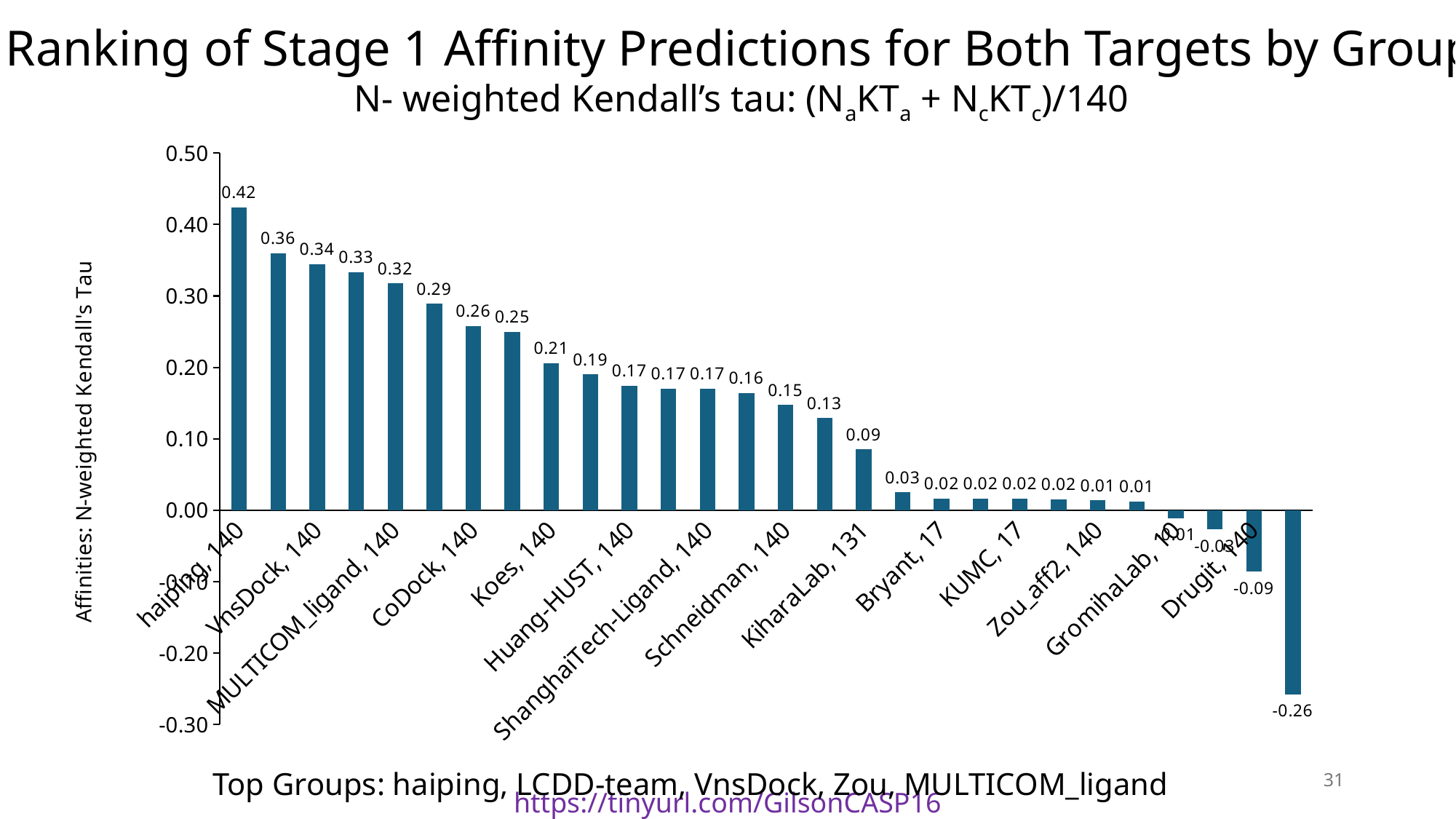
Which group has the highest N-weighted Kendall's tau? haiping, 140 What is the difference between the values for haiping, 140 and VnsDock, 140? 0.08 What type of chart is shown on the slide? bar chart How many bars are plotted in the chart? 28 What is the value shown for KiharaLab, 131? 0.09 Which has a larger value, Koes, 140 or CoDock, 140? CoDock, 140 What is the value shown for CoDock, 140? 0.26 What is the lowest value plotted in the chart? -0.26 What is the value shown for VnsDock, 140? 0.34 Do the values rise or fall moving from left to right along the x axis? fall What is the N-weighted Kendall's tau value for haiping, 140? 0.42 What is the value shown for MULTICOM_ligand, 140? 0.32